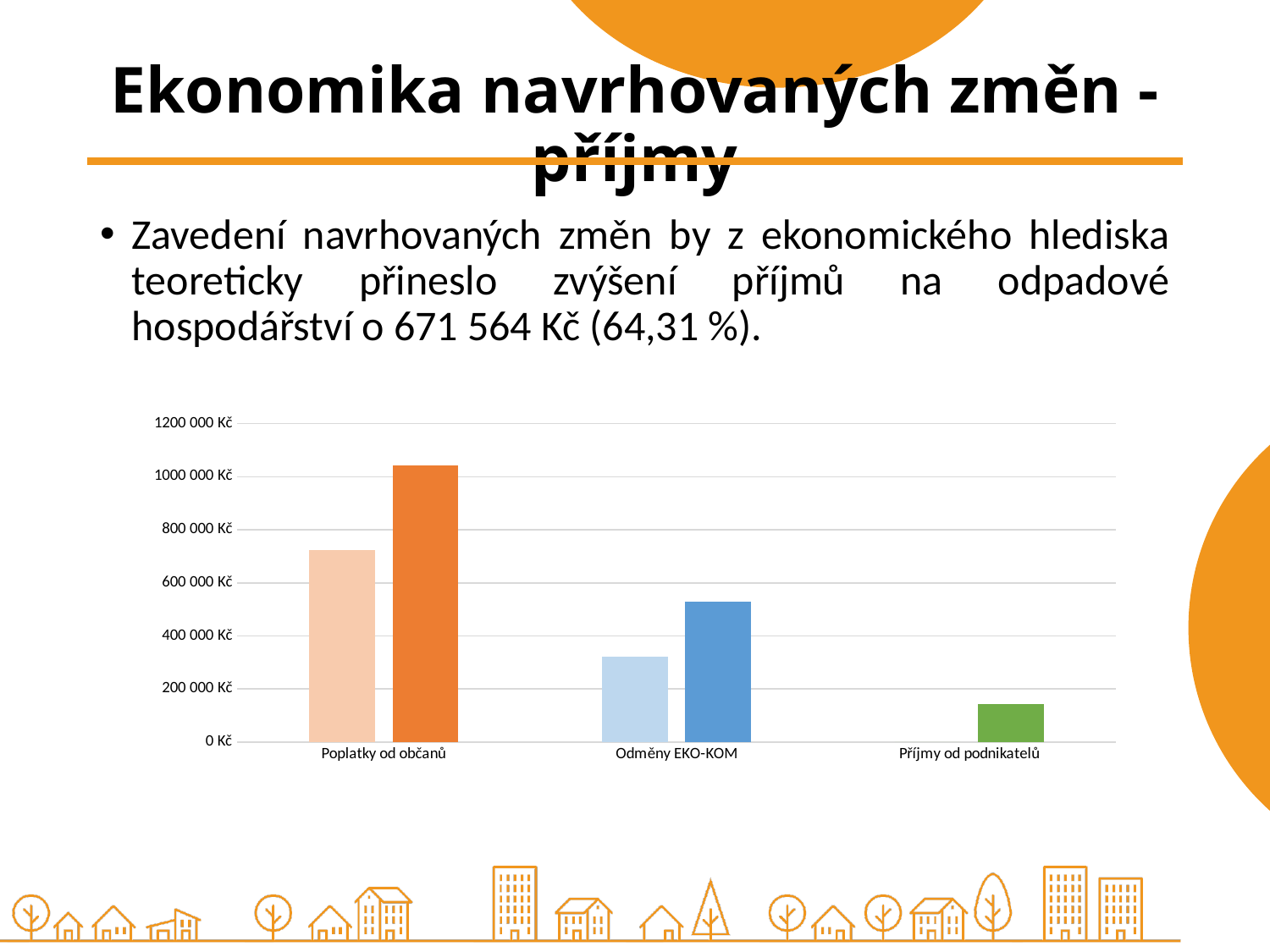
What kind of chart is shown on the slide? bar chart What colour is the bar for Příjmy od podnikatelů? green Is the value of the lighter blue bar for Odměny EKO-KOM greater or less than 400 000 Kč? less Which category has the tallest bar in the chart? Poplatky od občanů Which category has the shortest bar in the chart? Příjmy od podnikatelů Is the value for Příjmy od podnikatelů greater or less than 200 000 Kč? less Which is larger: the darker bar for Odměny EKO-KOM or the lighter bar for Poplatky od občanů? the lighter bar for Poplatky od občanů How many categories are shown on the x axis of the chart? 3 What is the highest value shown on the vertical axis of the chart? 1200 000 Kč Is the value of the lighter bar for Poplatky od občanů greater or less than 800 000 Kč? less